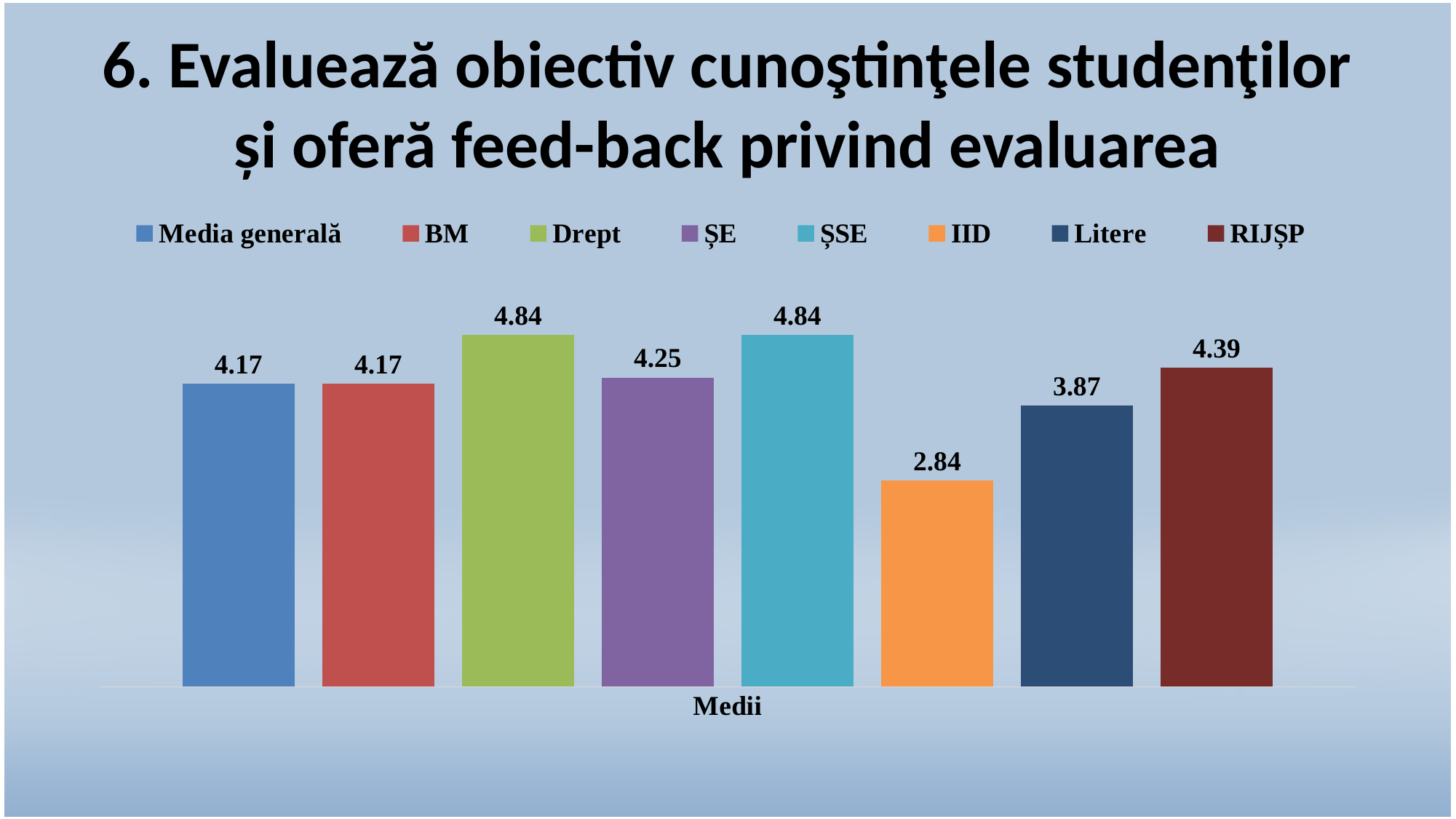
What kind of chart is shown on the slide? Bar chart Which series has the lowest value? IID What is the value for Litere? 3.87 How many series does the legend list? 8 What is the value for Media generală? 4.17 Which two series share the highest value of 4.84? Drept and ȘSE What is the value for ȘE? 4.25 What is the difference between the values for Drept and IID? 2 What is the value for RIJȘP? 4.39 Which is larger, the value for ȘE or the value for BM? ȘE What is the difference between the values for RIJȘP and Litere? 0.52 What is the value for IID? 2.84